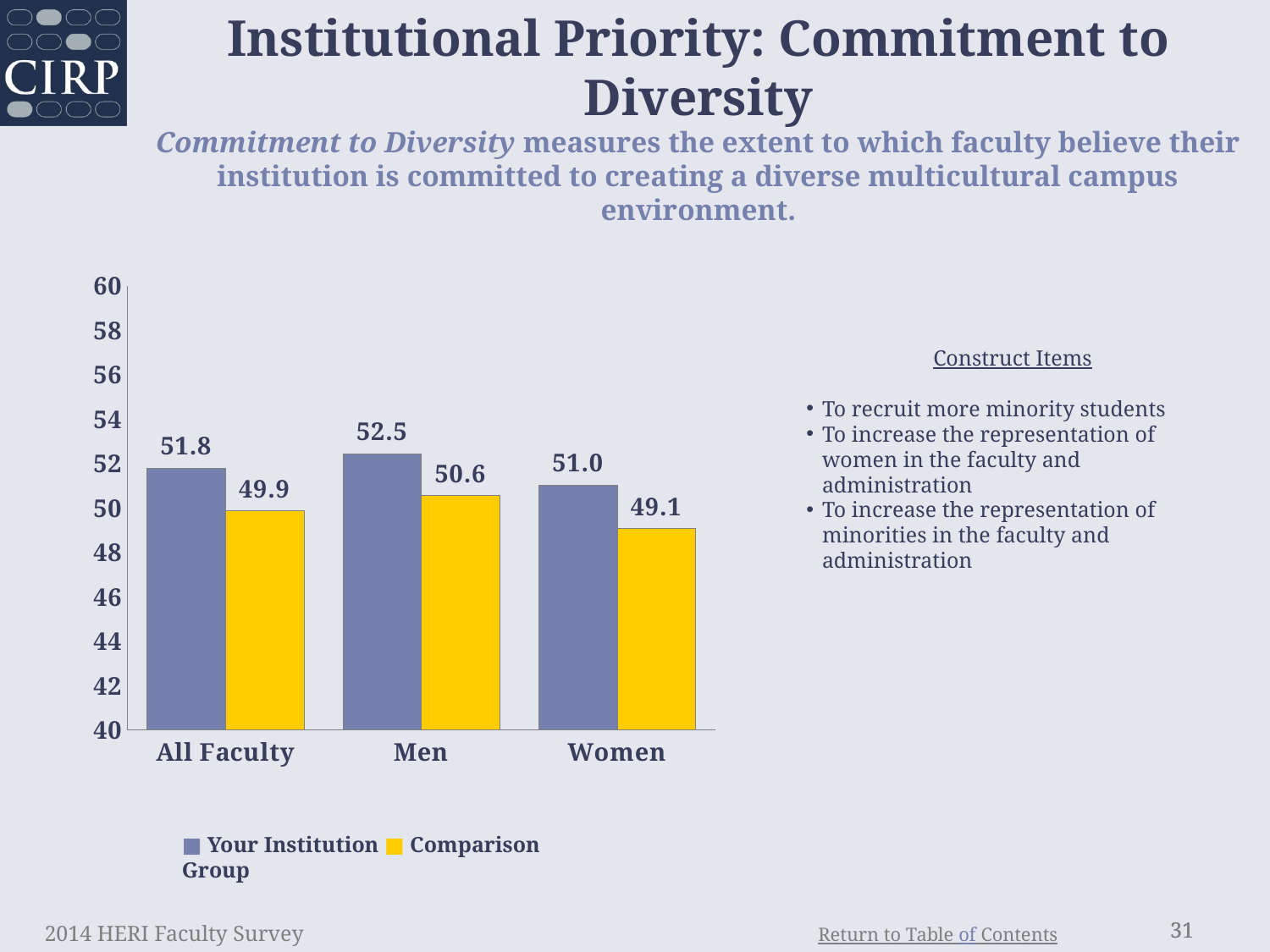
What is the difference between Your Institution and the Comparison Group in the Women category? 1.9 What is the value for the Comparison Group in the Women category? 49.1 What colour are the Comparison Group bars? yellow What kind of chart is shown on the slide? bar chart What is the value for Your Institution in the All Faculty category? 51.8 How many series does the legend list? 2 Which is larger in the Men category: Your Institution or the Comparison Group? Your Institution Is the value for the Comparison Group in the All Faculty category greater or less than 50? less How many categories are shown on the x axis? 3 Which category has the highest value for Your Institution? Men Which category has the lowest value for the Comparison Group? Women What is the value for the Comparison Group in the Men category? 50.6